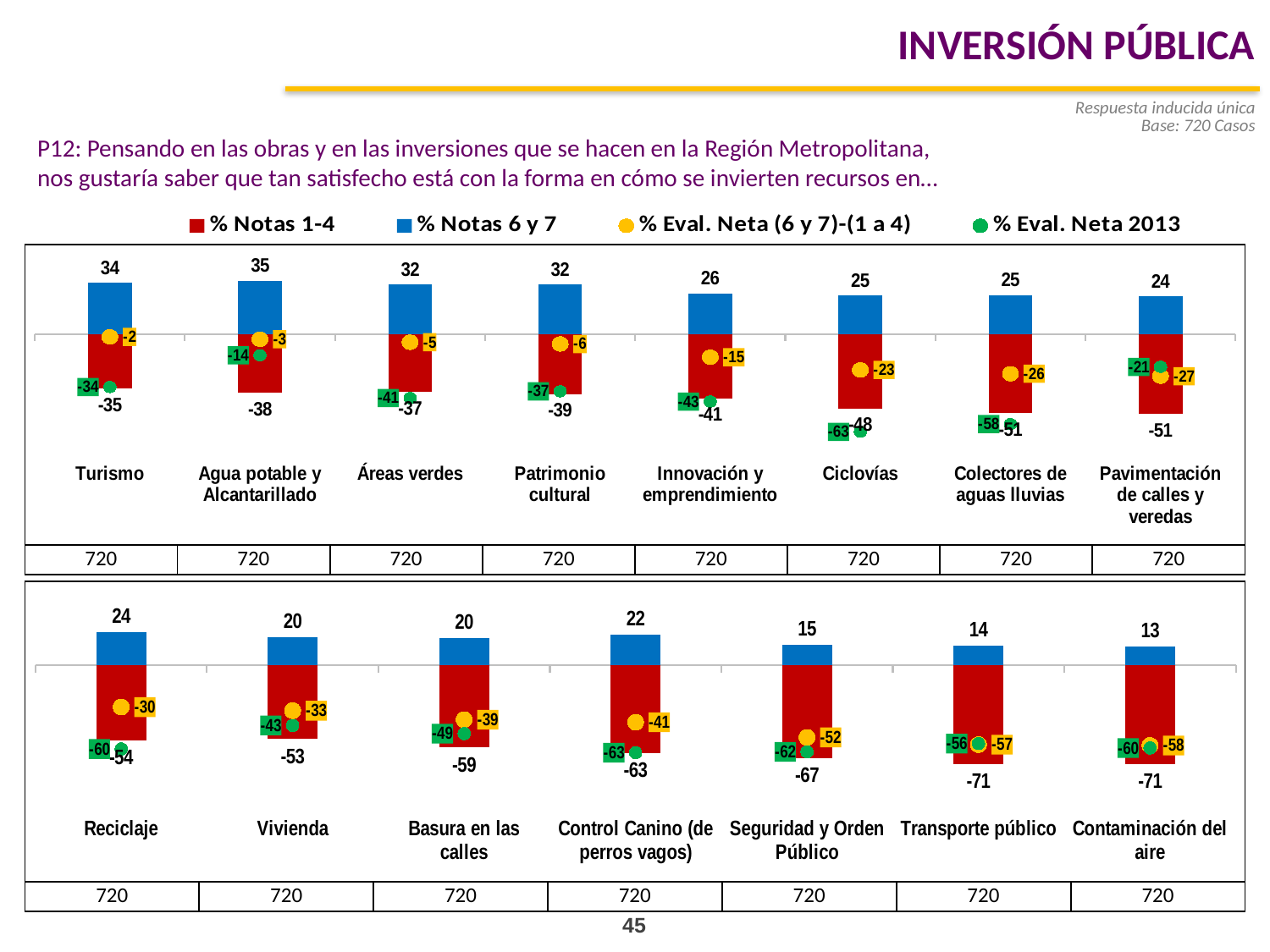
In the bottom chart, what is the % Notas 1-4 value for Transporte público? -71 How many series does the legend list? 4 How many categories are shown in the bottom chart? 7 In the top chart, what is the % Notas 6 y 7 value for Turismo? 34 What kind of chart is the top chart? Bar chart In the top chart, which category has the highest % Notas 6 y 7 value? Agua potable y Alcantarillado In the top chart, what is the difference between the % Notas 6 y 7 values for Turismo and Pavimentación de calles y veredas? 10 In the bottom chart, which has a higher % Notas 6 y 7 value, Reciclaje or Control Canino (de perros vagos)? Reciclaje In the top chart, what is the % Notas 1-4 value for Ciclovías? -48 In the bottom chart, what is the % Eval. Neta 2013 value for Vivienda? -43 In the bottom chart, which category has the lowest % Notas 6 y 7 value? Contaminación del aire In the top chart, what is the % Eval. Neta (6 y 7)-(1 a 4) value for Innovación y emprendimiento? -15